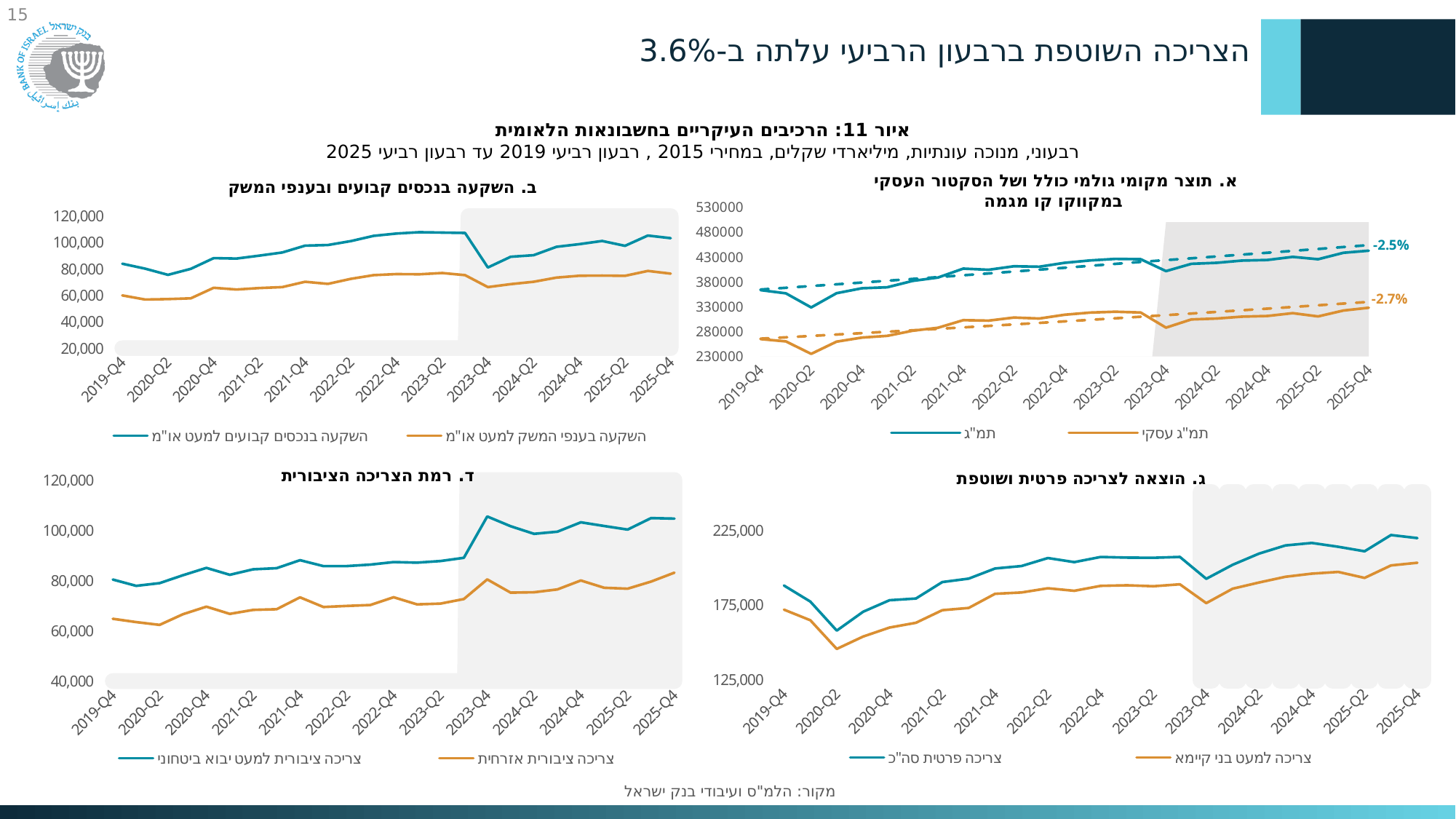
How many series does the legend of chart א (תוצר מקומי גולמי כולל ושל הסקטור העסקי) list? 2 How many charts are shown on the slide? 4 In chart ד, does צריכה ציבורית למעט יבוא ביטחוני rise or fall overall from 2019-Q4 to 2025-Q4? rise In chart ג (הוצאה לצריכה פרטית ושוטפת), is the value for צריכה פרטית סה"כ at 2020-Q2 greater or less than 175,000? less In chart א, what percentage label is printed at the end of the dashed trend line for תמ"ג עסקי? -2.7% In chart א, which series is higher throughout the period, תמ"ג or תמ"ג עסקי? תמ"ג In chart א, is the value for תמ"ג at 2025-Q4 greater or less than 430000? greater What kind of chart is chart ב (השקעה בנכסים קבועים ובענפי המשק)? Line chart In chart ג, at which quarter does צריכה פרטית סה"כ reach its lowest point? 2020-Q2 In chart א, what percentage label is printed at the end of the dashed trend line for תמ"ג? -2.5% In chart ד (רמת הצריכה הציבורית), is the value for צריכה ציבורית אזרחית at 2019-Q4 greater or less than 80,000? less